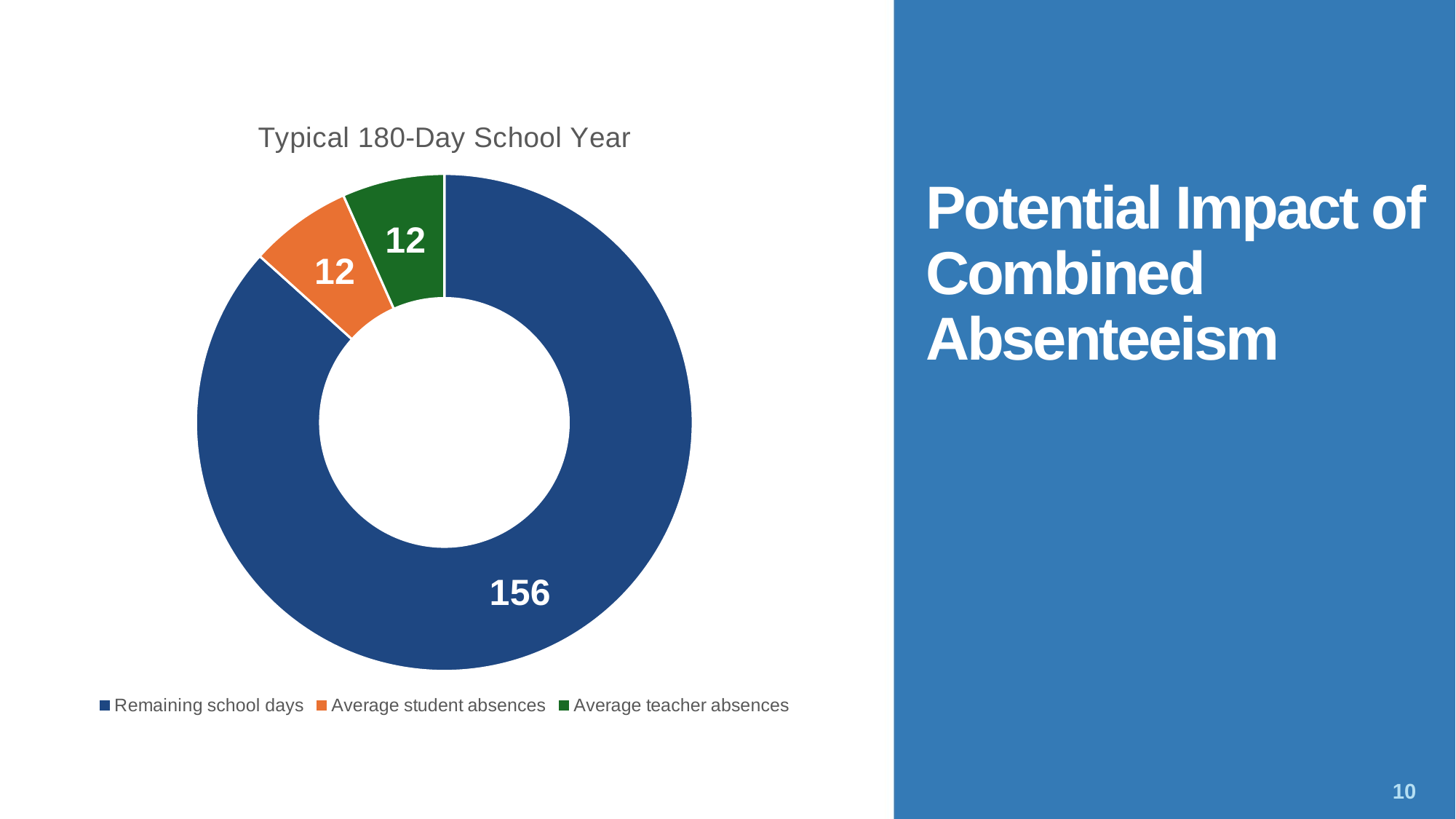
Which category has the largest slice? Remaining school days What is the value for Remaining school days? 156 What is the difference between Remaining school days and Average student absences? 144 What is the value for Average teacher absences? 12 How many categories does the chart show? 3 Which is larger, Remaining school days or Average teacher absences? Remaining school days What is the title of the chart? Typical 180-Day School Year What kind of chart is shown? Doughnut chart What is the value for Average student absences? 12 What colour is the Average student absences slice? Orange Is the value for Remaining school days greater or less than 100? greater What is the total of all slices in the chart? 180